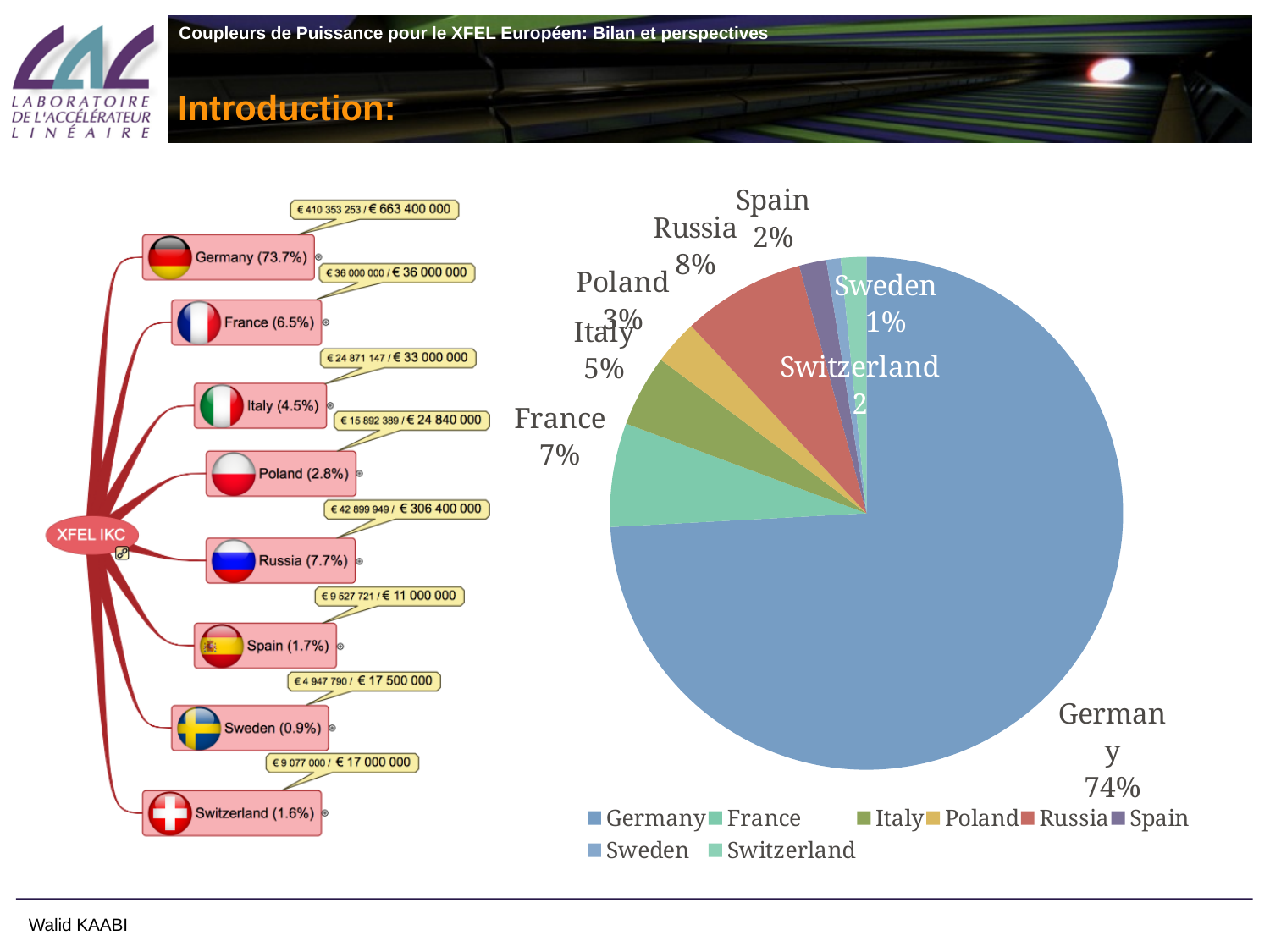
In the pie chart, what share is shown for France? 7% In the pie chart, which slice is larger, Russia or France? Russia In the pie chart, how many percentage points larger is Germany's share than Russia's? 66 Which country has the largest slice in the pie chart? Germany In the pie chart, what share is shown for Germany? 74% In the pie chart, what share is shown for Poland? 3% How many entries does the legend of the pie chart list? 8 In the pie chart, what share is shown for Italy? 5% What kind of chart is shown on the right side of the slide? pie chart Which country has the smallest slice in the pie chart? Sweden In the pie chart, what share is shown for Sweden? 1% In the pie chart, what share is shown for Russia? 8%